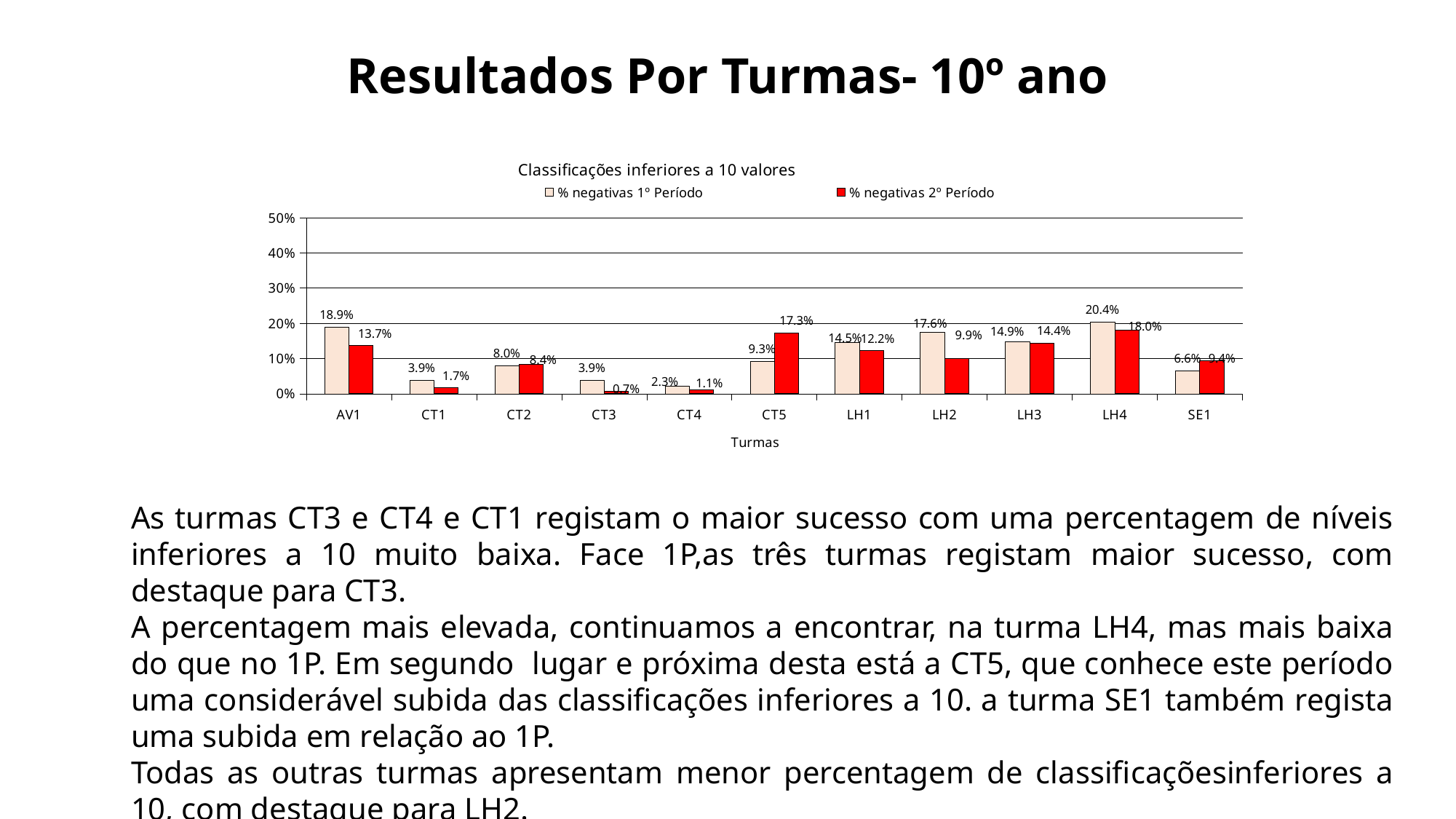
What is the difference between % negativas 1º Período and % negativas 2º Período for LH2? 7.7 percentage points What is the value of % negativas 2º Período for CT5? 17.3% Which turma has the lowest % negativas 1º Período? CT4 Is the value of % negativas 1º Período for LH4 greater or less than 20%? greater Which turma has the lowest % negativas 2º Período? CT3 How many turmas are shown on the x axis? 11 What is the value of % negativas 1º Período for AV1? 18.9% What is the value of % negativas 2º Período for CT3? 0.7% What kind of chart is shown on the slide? bar chart Which turma has the highest % negativas 1º Período? LH4 How many series does the legend list? 2 For CT5, which is larger: % negativas 1º Período or % negativas 2º Período? % negativas 2º Período